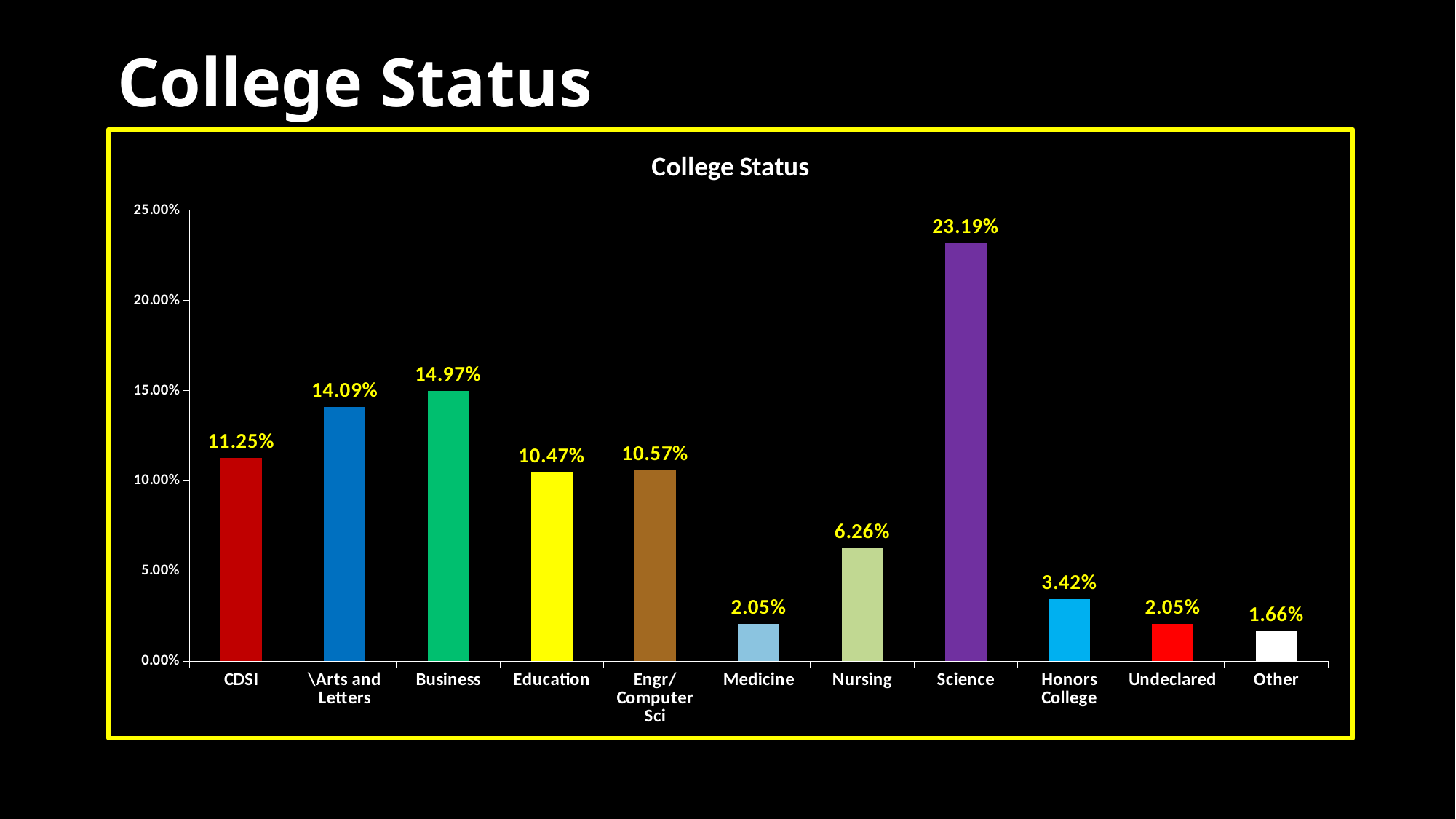
Which category has the highest value? Science What is the value for Business? 14.97% What is the difference between the values for Science and Business? 8.22% What is the value for Science? 23.19% How many categories are shown on the x axis? 11 What is the difference between the values for Engr/Computer Sci and Education? 0.10% What is the value for Nursing? 6.26% Which category has the lowest value? Other Which is larger, the value for CDSI or the value for Arts and Letters? Arts and Letters What is the title of the chart? College Status Is the value for Honors College greater or less than 5.00%? less What kind of chart is shown? bar chart